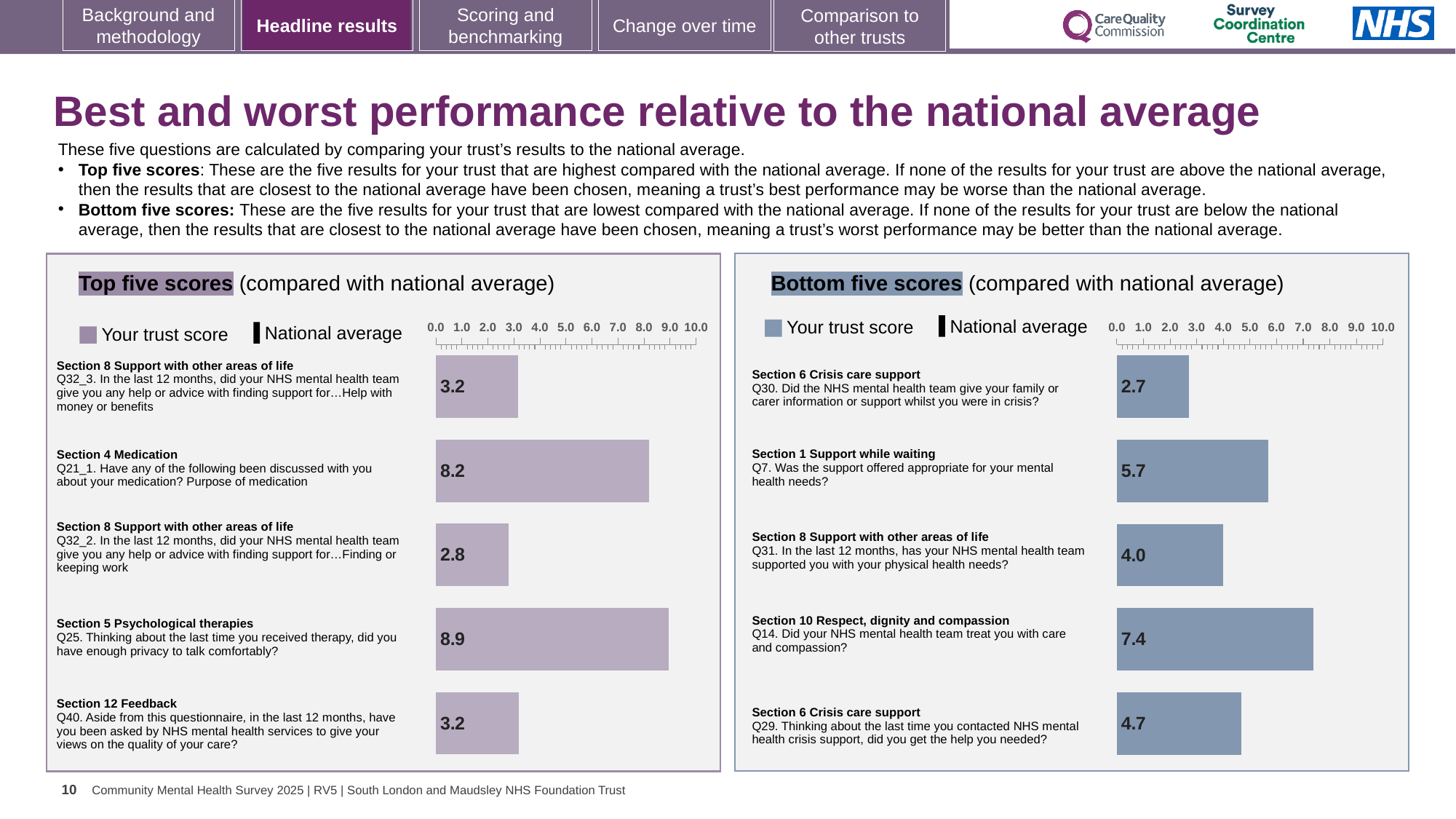
In the Bottom five scores chart, which has the larger trust score, Q29 or Q31? Q29 In the Bottom five scores chart, which question has the lowest trust score? Q30 (family or carer information or support in crisis), 2.7 In the Top five scores chart, which question has the highest trust score? Q25 (enough privacy to talk comfortably), 8.9 In the Top five scores chart, what is the trust score for Q21_1 (Purpose of medication)? 8.2 In the Bottom five scores chart, what is the difference between the trust scores for Q7 and Q31? 1.7 How many bars are shown in the Top five scores chart? 5 In the Bottom five scores chart, what is the trust score for Q14 (treated with care and compassion)? 7.4 In the Top five scores chart, what is the difference between the trust scores for Q25 and Q21_1? 0.7 In the Top five scores chart, what is the trust score for Q40 (asked to give views on the quality of your care)? 3.2 In the Top five scores chart, which question has the lowest trust score? Q32_2 (Finding or keeping work), 2.8 What type of chart is used for the Bottom five scores? Bar chart In the Bottom five scores chart, which question has the highest trust score? Q14 (treated with care and compassion), 7.4